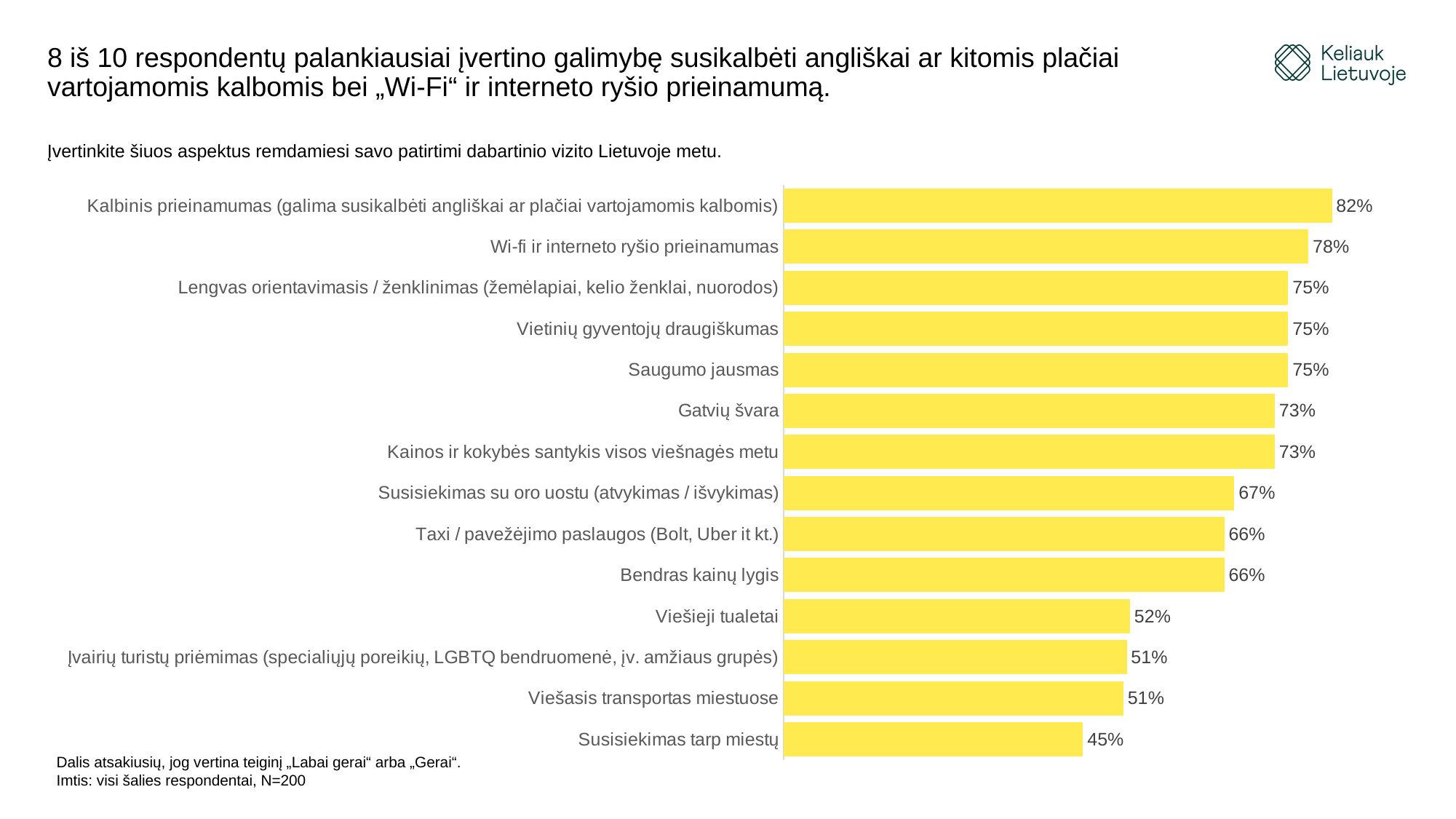
What is the value for "Susisiekimas su oro uostu (atvykimas / išvykimas)"? 67% Which category has the highest value? Kalbinis prieinamumas (galima susikalbėti angliškai ar plačiai vartojamomis kalbomis) How many categories are shown in the chart? 14 Which is larger: the value for "Viešieji tualetai" or the value for "Bendras kainų lygis"? Bendras kainų lygis What colour are the bars in the chart? Yellow What kind of chart is shown on the slide? Bar chart What is the value for "Viešieji tualetai"? 52% What is the difference between the values for "Wi-fi ir interneto ryšio prieinamumas" and "Gatvių švara"? 5% What is the value for "Saugumo jausmas"? 75% What is the value for "Wi-fi ir interneto ryšio prieinamumas"? 78% Which category has the lowest value? Susisiekimas tarp miestų What is the difference between the values for "Kalbinis prieinamumas" and "Susisiekimas tarp miestų"? 37%